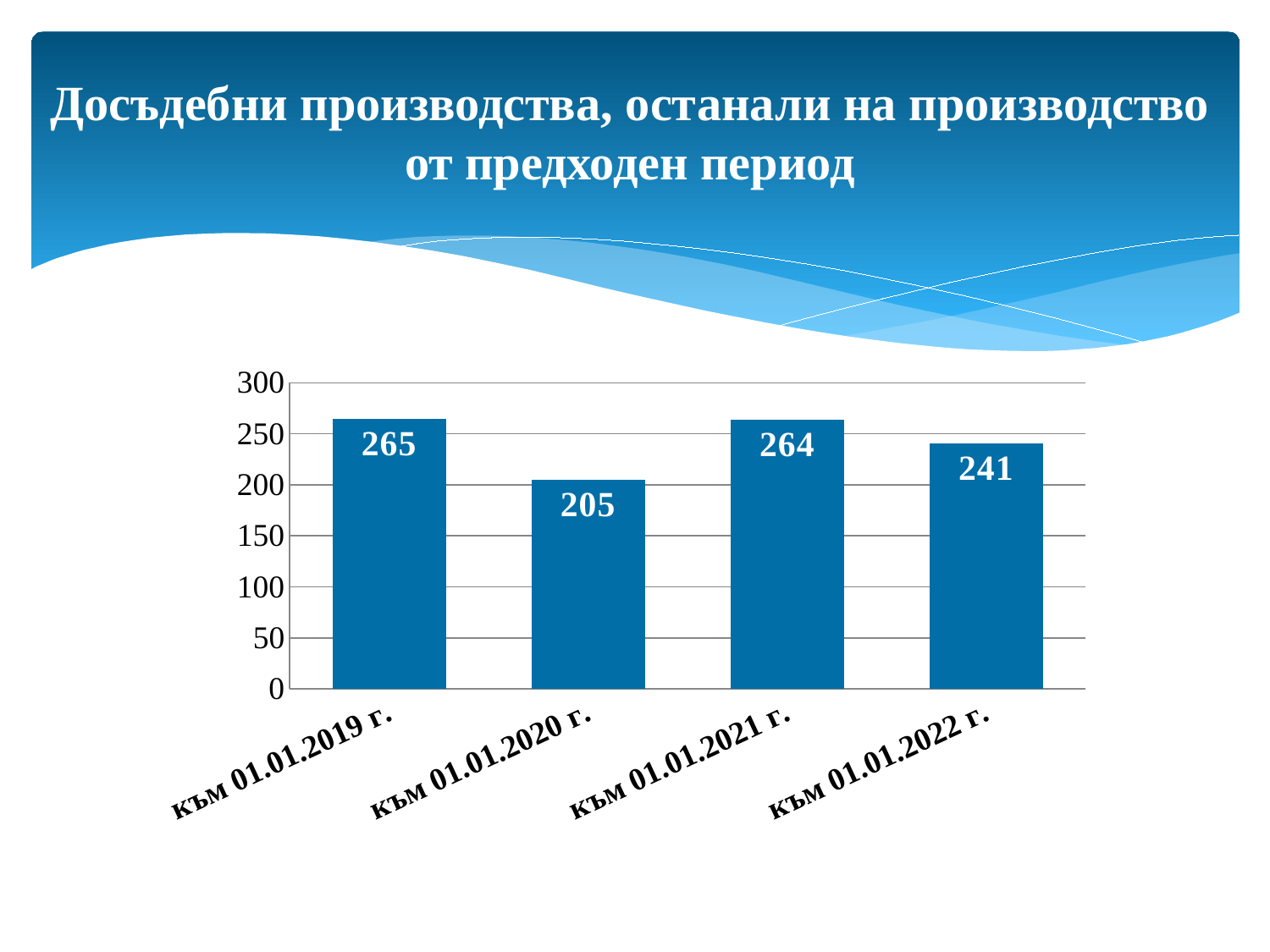
What kind of chart is shown on the slide? bar chart What is the value for към 01.01.2020 г.? 205 Is the value for към 01.01.2020 г. greater or less than 250? less What is the value for към 01.01.2021 г.? 264 What is the difference between the values for към 01.01.2021 г. and към 01.01.2022 г.? 23 What is the difference between the values for към 01.01.2019 г. and към 01.01.2020 г.? 60 Which is larger, the value for към 01.01.2022 г. or the value for към 01.01.2020 г.? към 01.01.2022 г. What is the value for към 01.01.2019 г.? 265 How many categories are shown on the x axis? 4 What is the title of the slide? Досъдебни производства, останали на производство от предходен период Which category has the lowest value? към 01.01.2020 г. What is the value for към 01.01.2022 г.? 241